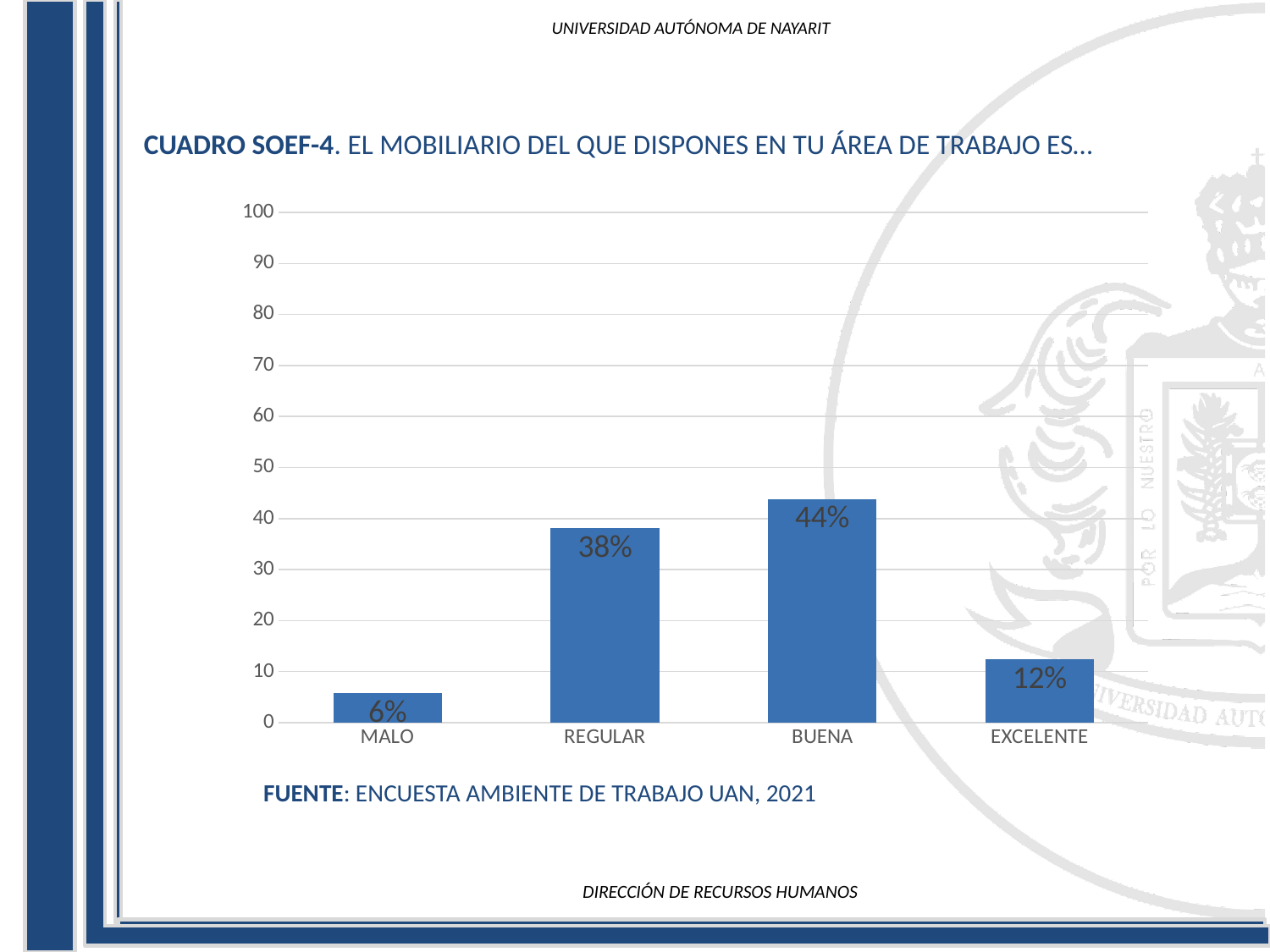
Which category has the lowest value? MALO How many categories are shown on the x axis? 4 What is the value for MALO? 6% What is the value for REGULAR? 38% What is the difference between the values for BUENA and REGULAR? 6% What is the maximum value shown on the y axis? 100 Is the value for BUENA greater or less than 50? less What is the value for EXCELENTE? 12% What kind of chart is shown on the slide? bar chart Which category has the highest value? BUENA Which is larger, the value for EXCELENTE or the value for MALO? EXCELENTE What source is cited below the chart? ENCUESTA AMBIENTE DE TRABAJO UAN, 2021